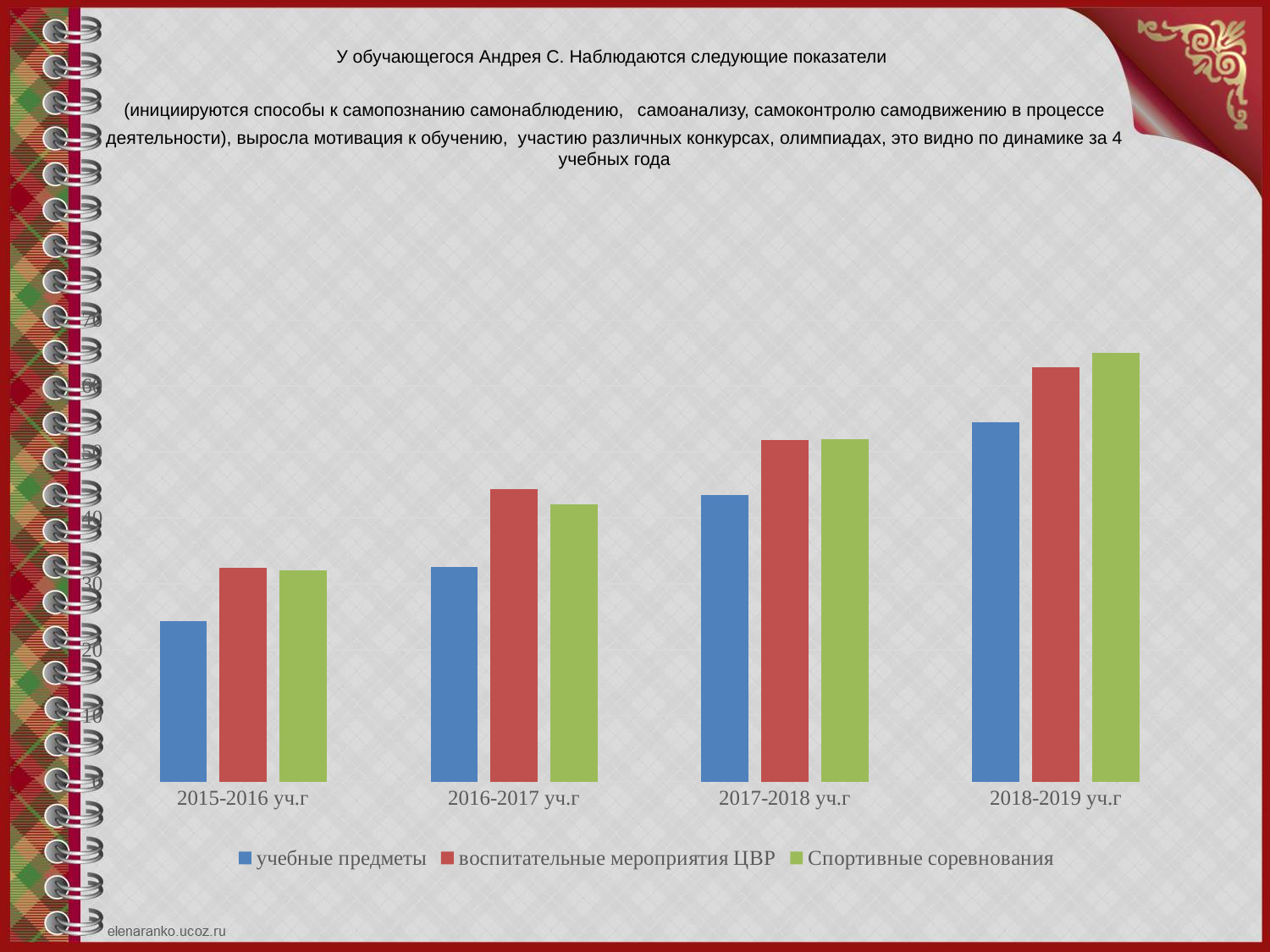
Is the value for Спортивные соревнования in 2017-2018 уч.г greater or less than 40? greater What colour represents Спортивные соревнования in the legend? green In 2018-2019 уч.г, which is larger: учебные предметы or Спортивные соревнования? Спортивные соревнования Is the value for воспитательные мероприятия ЦВР in 2018-2019 уч.г greater or less than 60? greater In which academic year is the value for учебные предметы highest? 2018-2019 уч.г What kind of chart is shown on the slide? bar chart How many academic years (categories) are shown on the x axis? 4 In which academic year is the value for Спортивные соревнования lowest? 2015-2016 уч.г Is the value for учебные предметы in 2015-2016 уч.г greater or less than 30? less In 2016-2017 уч.г, which is larger: учебные предметы or воспитательные мероприятия ЦВР? воспитательные мероприятия ЦВР Do the values for учебные предметы rise or fall from 2015-2016 уч.г to 2018-2019 уч.г? rise How many series does the legend list? 3